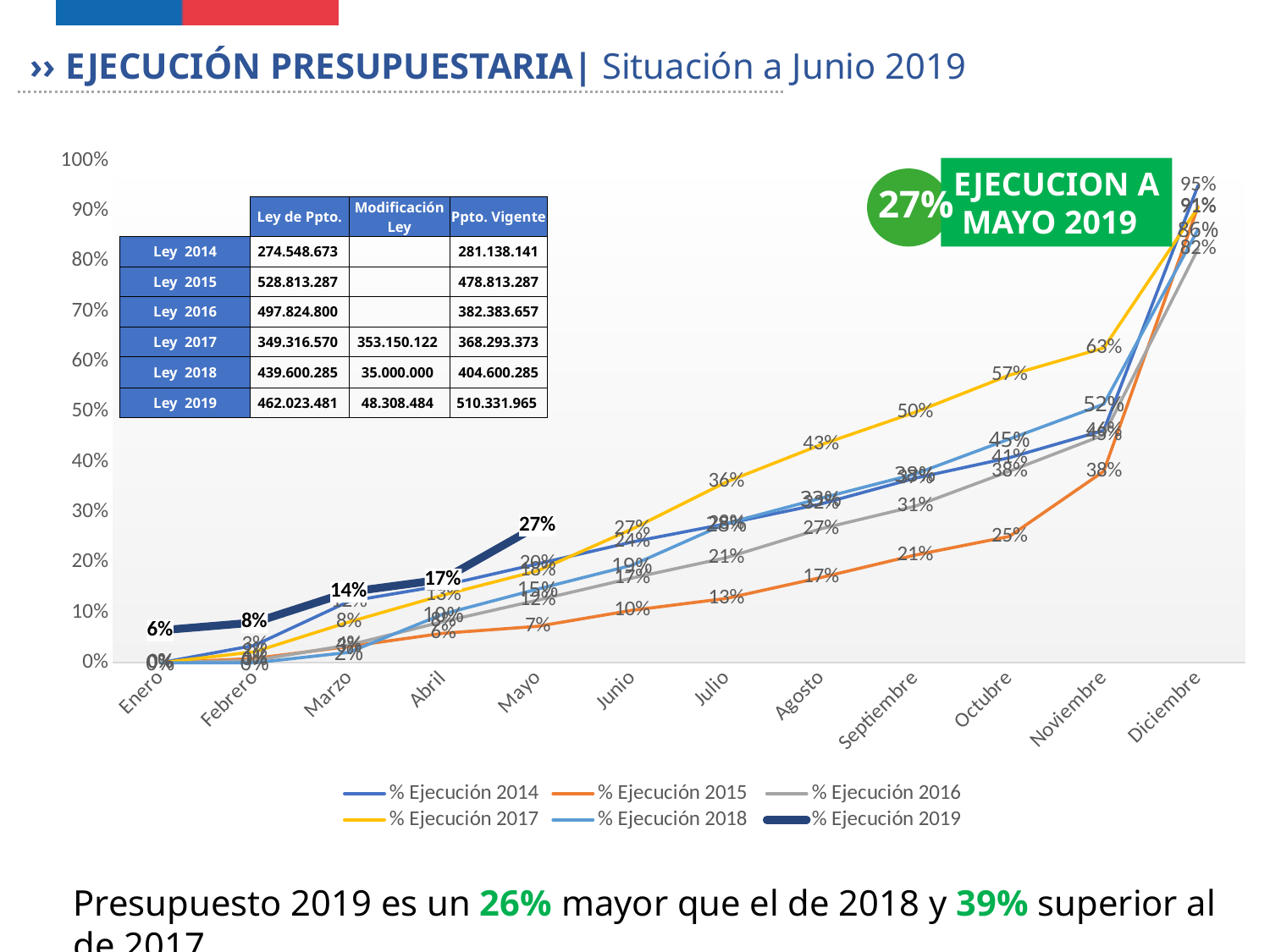
By how many percentage points does % Ejecución 2019 increase from Abril (17%) to Mayo (27%)? 10 percentage points What kind of chart is shown on the slide? Line chart What is the value of % Ejecución 2017 in Noviembre? 63% Does the % Ejecución 2019 line rise or fall from Enero to Mayo? Rises What is the value of % Ejecución 2015 in Noviembre? 38% What percentage is shown in the green circle next to the label 'EJECUCION A MAYO 2019'? 27% How many series does the chart legend list? 6 Which is larger in Septiembre: % Ejecución 2017 or % Ejecución 2015? % Ejecución 2017 What is the value of % Ejecución 2019 in Marzo? 14% What is the value of % Ejecución 2019 in Mayo? 27% What is the value of % Ejecución 2019 in Enero? 6% How many months are shown along the x axis of the chart? 12